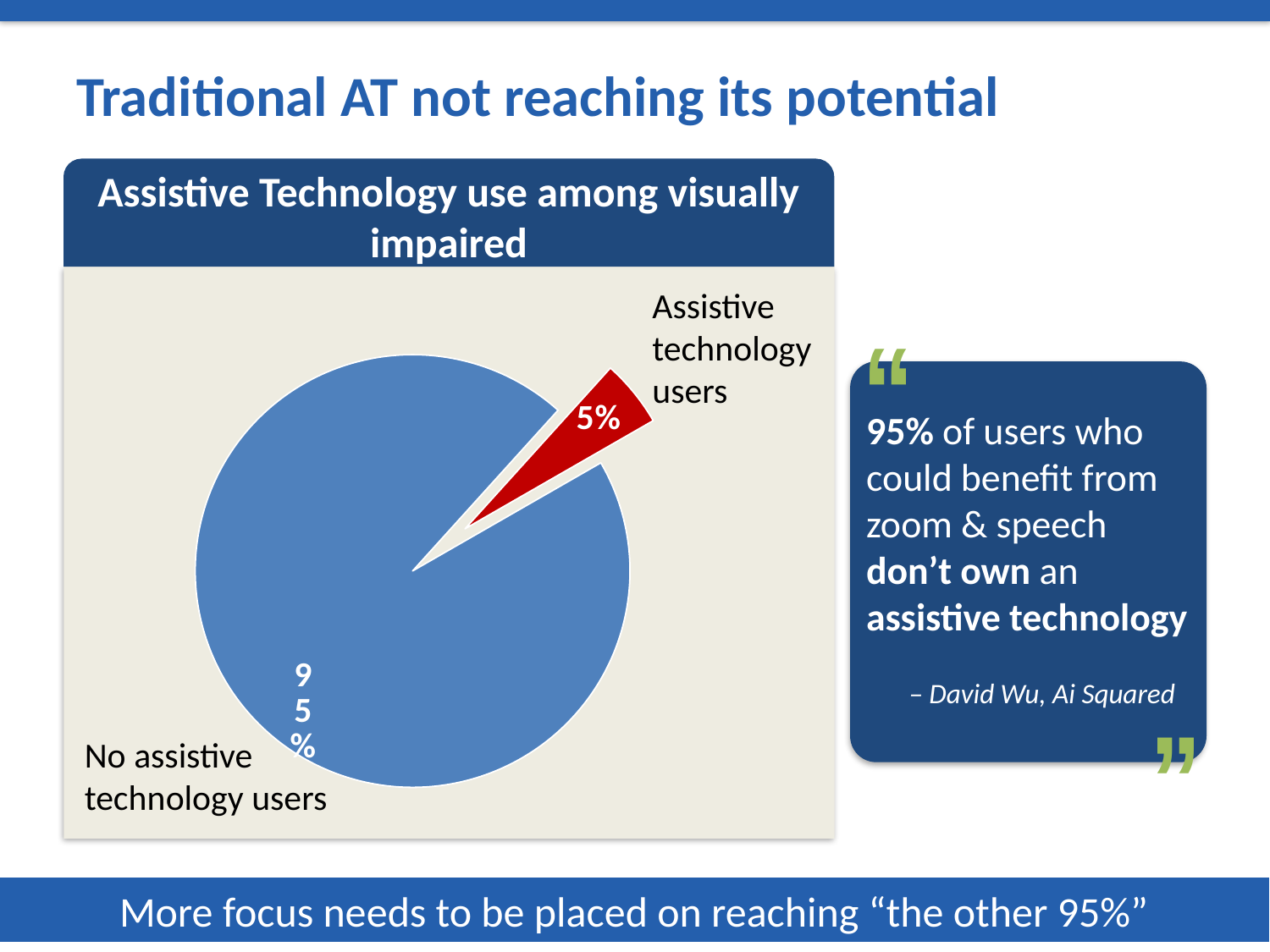
What kind of chart is shown on the slide? pie chart Which is larger: the "Assistive technology users" slice or the "No assistive technology users" slice? No assistive technology users Which slice of the pie is the largest? No assistive technology users What share of the pie is labelled "Assistive technology users"? 5% What colour is the "Assistive technology users" slice? red Which slice of the pie is the smallest? Assistive technology users Is the share for "Assistive technology users" greater or less than 50%? less What share of the pie is labelled "No assistive technology users"? 95% What is the difference in percentage points between the "No assistive technology users" slice and the "Assistive technology users" slice? 90 How many slices does the pie chart have? 2 What is the title of the chart? Assistive Technology use among visually impaired